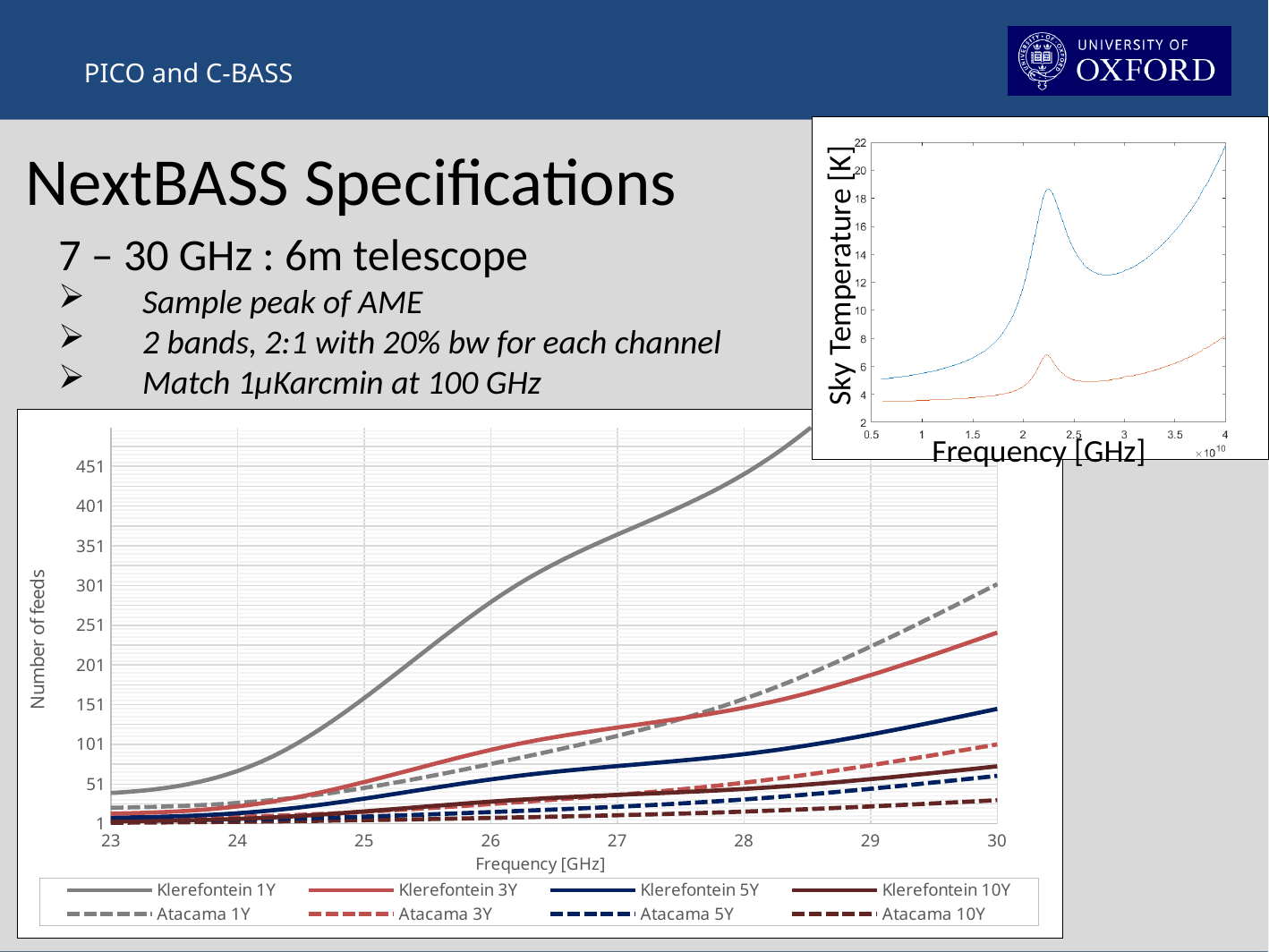
In the Number of feeds chart, how many series does the legend list? 8 In the Number of feeds chart, is the Klerefontein 5Y value at 30 GHz greater or less than 101? greater In the Number of feeds chart, at 30 GHz which is larger: Klerefontein 3Y or Klerefontein 5Y? Klerefontein 3Y In the Sky Temperature chart at the top right, is the peak of the blue line greater or less than 16 K? greater What kind of chart is the large chart at the bottom of the slide showing Number of feeds against Frequency? line chart In the Sky Temperature chart at the top right, how many lines are plotted? 2 In the Number of feeds chart, at 30 GHz which is larger: Atacama 1Y or Klerefontein 3Y? Atacama 1Y In the Number of feeds chart, is the Atacama 10Y value at 30 GHz greater or less than 51? less In the Number of feeds chart, which series has the highest value at 30 GHz? Klerefontein 1Y In the Number of feeds chart, which series has the lowest value at 30 GHz? Atacama 10Y In the Number of feeds chart, does the Klerefontein 1Y line rise or fall as frequency increases from 23 to 30 GHz? rise